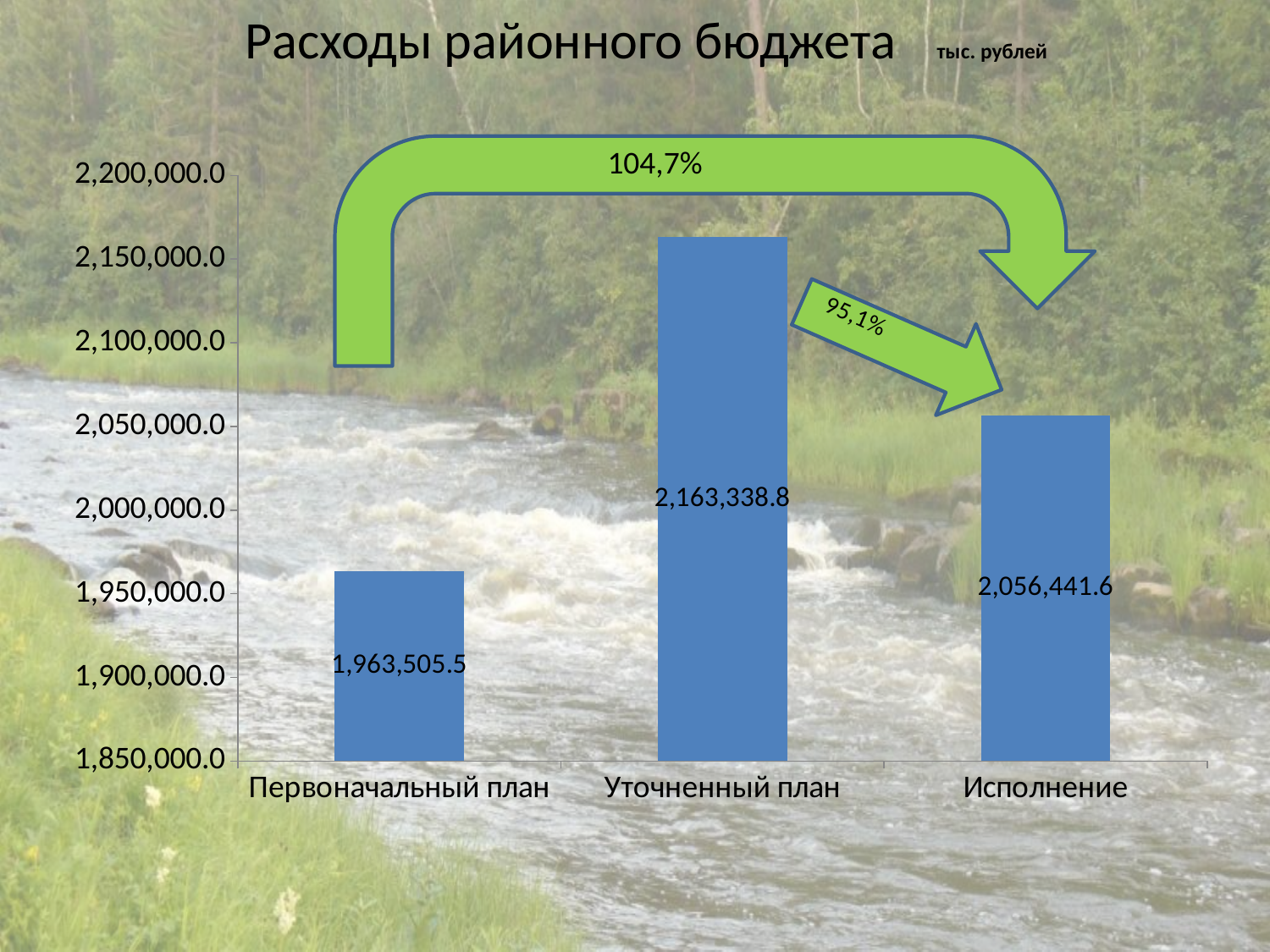
What is the value for Уточненный план? 2,163,338.8 Which category has the lowest value? Первоначальный план What is the value for Исполнение? 2,056,441.6 How many categories are shown on the chart? 3 Is the value for Исполнение greater or less than 2,050,000.0? greater What kind of chart is shown on the slide? bar chart What is the value for Первоначальный план? 1,963,505.5 Which is larger, Исполнение or Первоначальный план? Исполнение What is the difference between Уточненный план and Первоначальный план? 199,833.3 What is the difference between Уточненный план and Исполнение? 106,897.2 Which category has the highest value? Уточненный план What is the title of the chart? Расходы районного бюджета